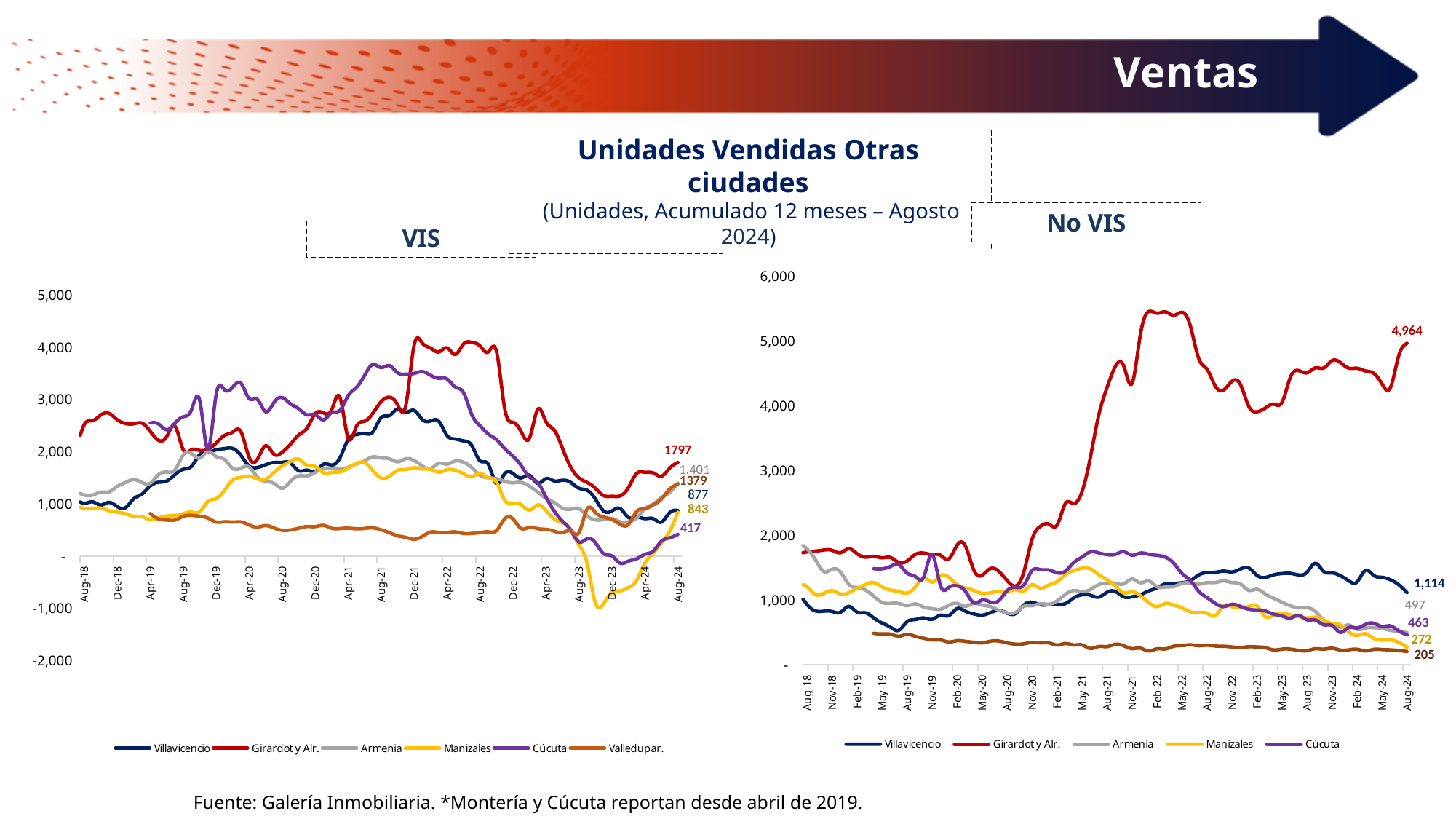
In the No VIS chart, is the peak value of Girardot y Alr. around Feb-22 greater or less than 5,000? greater In the VIS chart, which is larger at Aug-24: Villavicencio or Manizales? Villavicencio In the VIS chart, what is the value labelled for Cúcuta at Aug-24? 417 In the No VIS chart, what is the difference between the Aug-24 values of Girardot y Alr. and Villavicencio? 3,850 In the VIS chart, what is the value labelled for Girardot y Alr. at Aug-24? 1797 How many series does the legend of the VIS chart list? 6 In the VIS chart, which city has the highest value at Aug-24? Girardot y Alr. In the VIS chart, what is the value labelled for Valledupar at Aug-24? 1379 What kind of chart is the VIS chart on the left? line chart In the No VIS chart, what is the value labelled for Girardot y Alr. at Aug-24? 4,964 How many series does the legend of the No VIS chart list? 5 In the No VIS chart, what is the value labelled for Villavicencio at Aug-24? 1,114